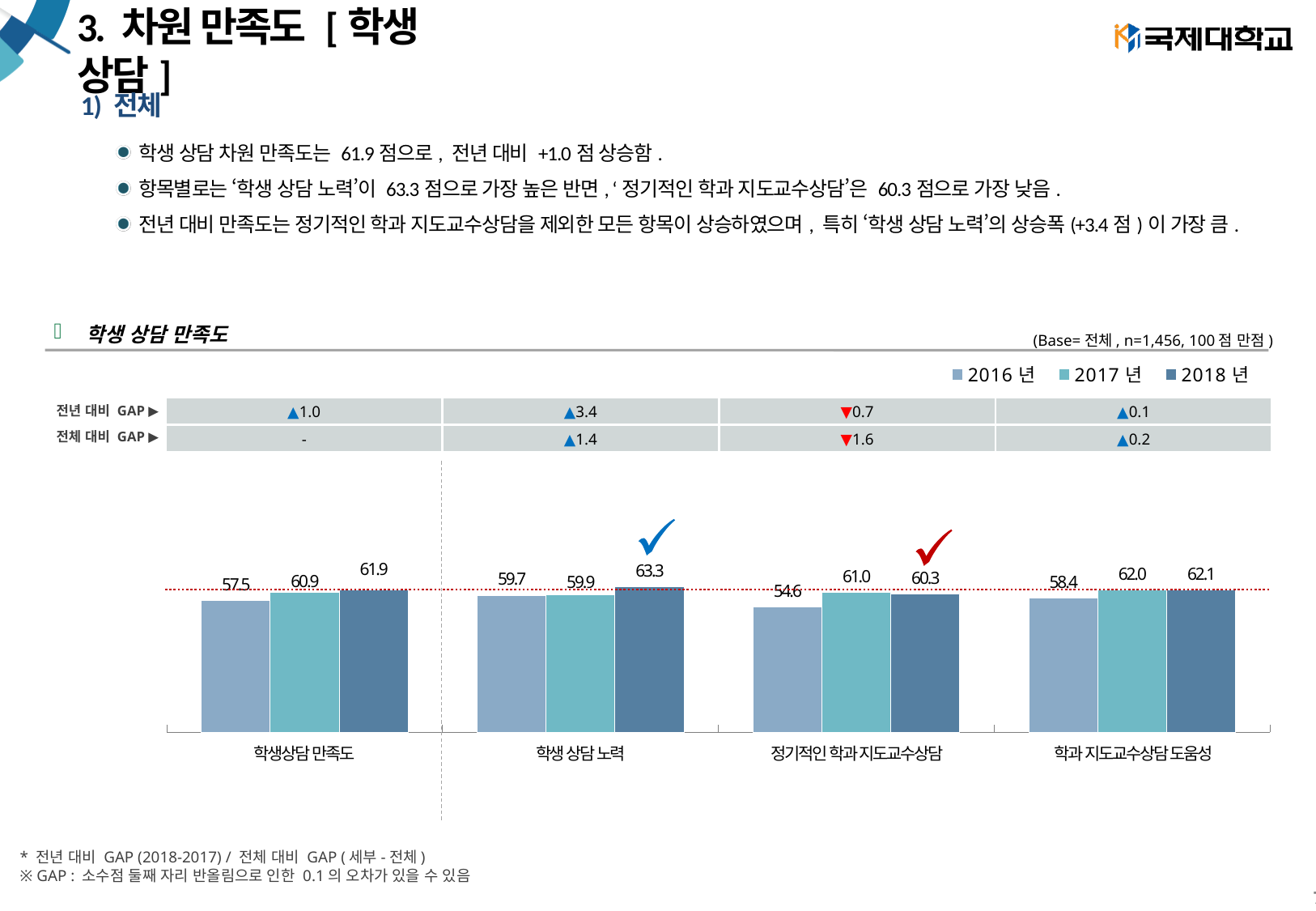
What is the 2017년 value for 학과 지도교수상담 도움성? 62.0 How many series does the chart legend list? 3 Do the values for 학생상담 만족도 rise or fall from 2016년 to 2018년? rise What type of chart is shown on the slide? bar chart How many categories are shown on the x axis of the chart? 4 What is the 전년 대비 GAP shown for 정기적인 학과 지도교수상담? ▼0.7 Which is larger for 정기적인 학과 지도교수상담: the 2017년 value or the 2018년 value? 2017년 Which category has the lowest 2016년 value? 정기적인 학과 지도교수상담 Which category has the highest 2018년 value? 학생 상담 노력 What is the 2018년 value for 학생 상담 노력? 63.3 What is the difference between the 2018년 and 2017년 values for 학생 상담 노력? 3.4 What is the 2016년 value for 정기적인 학과 지도교수상담? 54.6